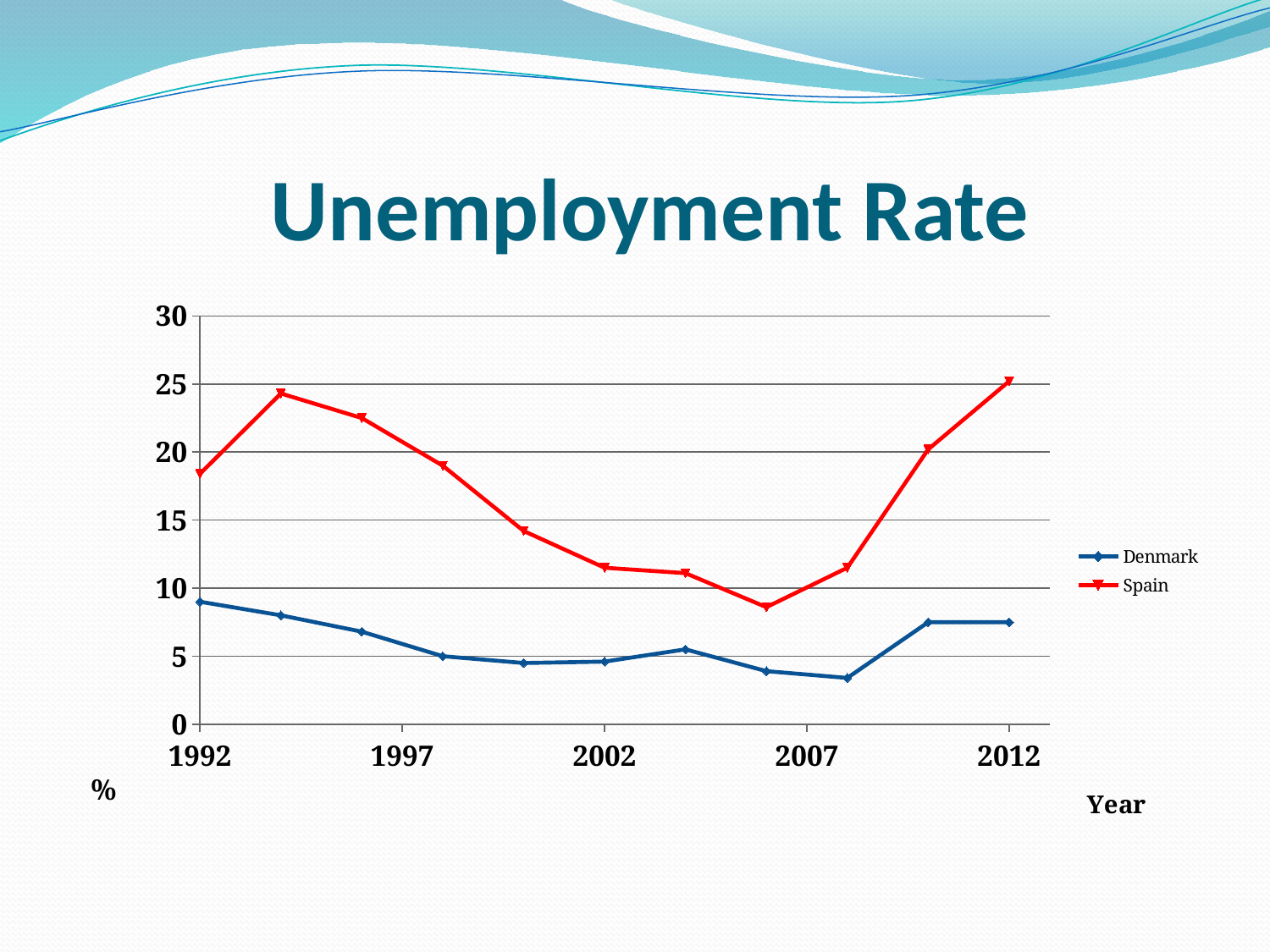
What is the title of the chart? Unemployment Rate Is the value for Denmark in 2012 greater or less than 10? less Is the value for Spain in 2012 greater or less than 20? greater Is the value for Denmark in 1992 greater or less than 10? less In 2002, which country has the higher unemployment rate, Denmark or Spain? Spain What kind of chart is shown on the slide? line chart Does the Spain line rise or fall between 2007 and 2012? rise Which two countries are shown in the legend? Denmark and Spain Which series has the lower values across the whole period? Denmark How many data points does the Spain line have? 11 How many series does the legend list? 2